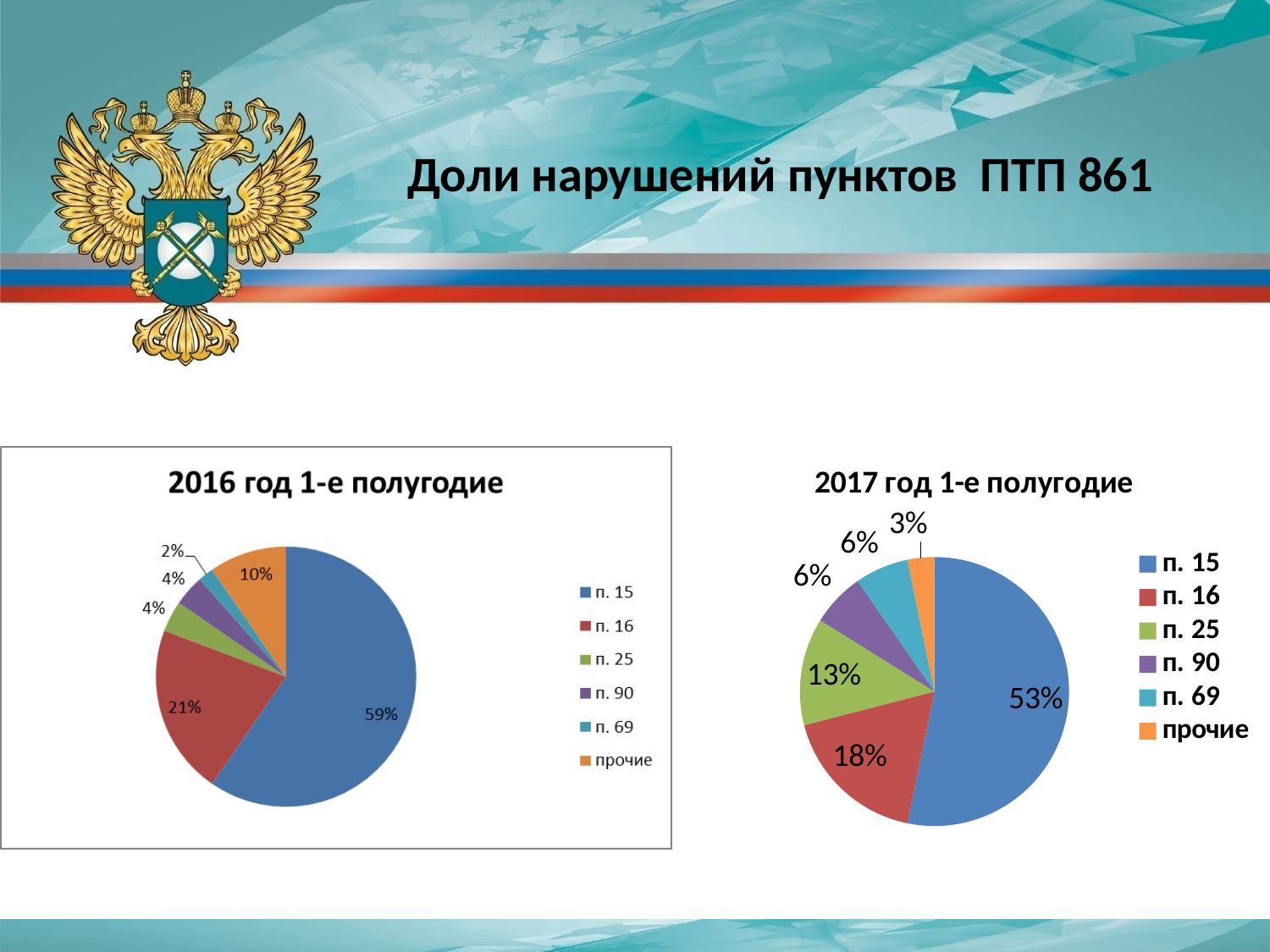
What is the title of the chart on the right side of the slide? 2017 год 1-е полугодие In the chart titled "2016 год 1-е полугодие", which category has the smallest share? п. 69 What type of chart is the one titled "2016 год 1-е полугодие"? Pie chart In the chart titled "2016 год 1-е полугодие", what share does п. 15 have? 59% In the chart titled "2017 год 1-е полугодие", which category has the largest share? п. 15 In the chart titled "2017 год 1-е полугодие", which category has the smallest share? прочие In the chart titled "2017 год 1-е полугодие", what share does п. 25 have? 13% In the chart titled "2017 год 1-е полугодие", what share does п. 16 have? 18% In the chart titled "2017 год 1-е полугодие", which is larger: the share of п. 16 or the share of п. 25? п. 16 In the chart titled "2016 год 1-е полугодие", what is the difference between the shares of п. 15 and п. 16? 38% In the chart titled "2016 год 1-е полугодие", what share does прочие have? 10% How many categories does the legend of the chart titled "2017 год 1-е полугодие" list? 6